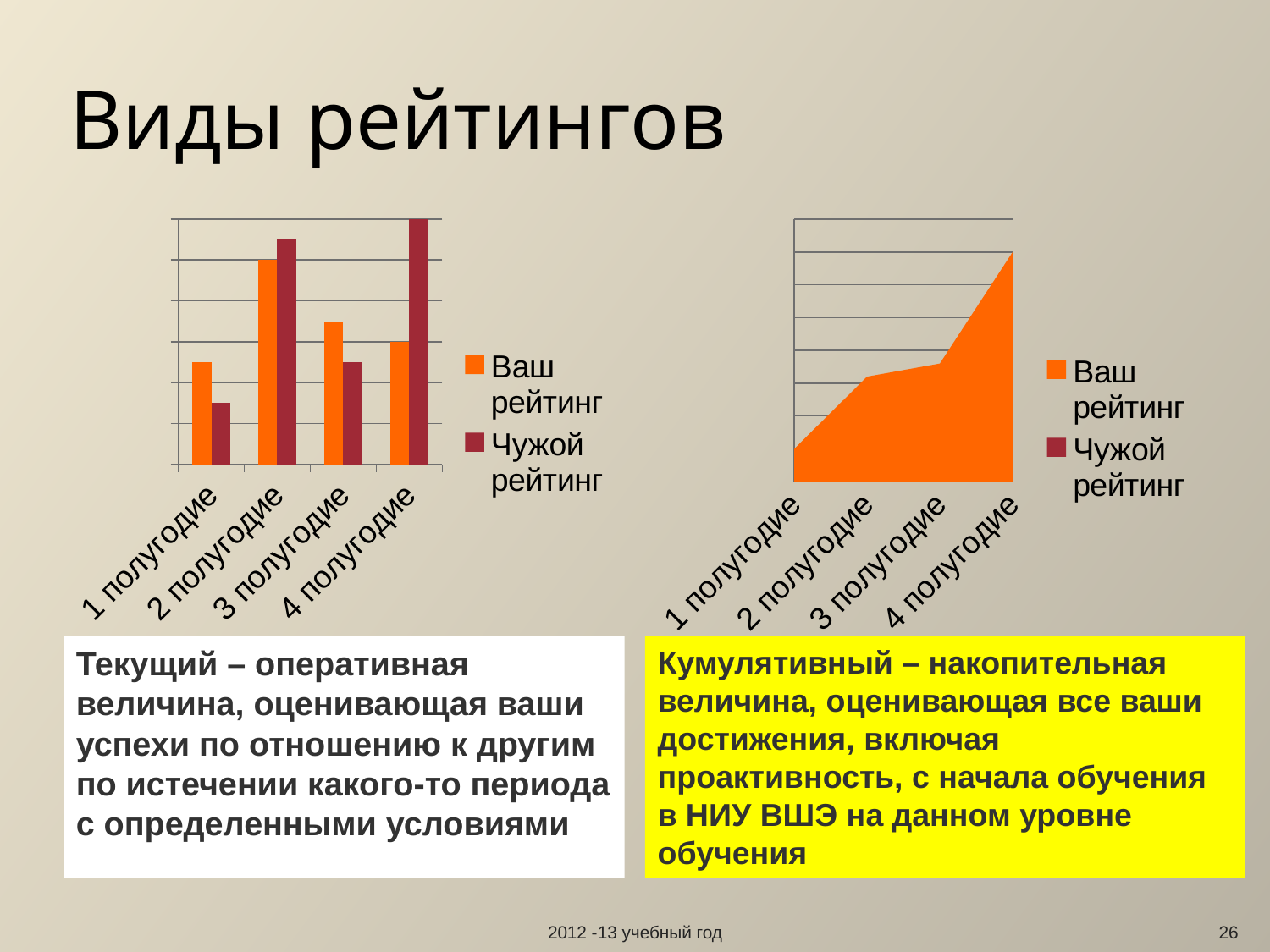
In the left chart, for 4 полугодие, which series has the larger value: Ваш рейтинг or Чужой рейтинг? Чужой рейтинг How many categories are shown on the x axis of the left chart? 4 How many series does the legend of the left chart list? 2 What kind of chart is the chart on the left of the slide? bar chart In the left chart, which category has the lowest value for Чужой рейтинг? 1 полугодие In the right chart, does the value for Ваш рейтинг rise or fall from 1 полугодие to 4 полугодие? rise What are the two legend entries of the right chart? Ваш рейтинг, Чужой рейтинг What kind of chart is the chart on the right of the slide? area chart In the left chart, which category has the lowest value for Ваш рейтинг? 1 полугодие In the left chart, for 3 полугодие, which series has the larger value: Ваш рейтинг or Чужой рейтинг? Ваш рейтинг In the left chart, which category has the highest value for Чужой рейтинг? 4 полугодие In the left chart, which category has the highest value for Ваш рейтинг? 2 полугодие